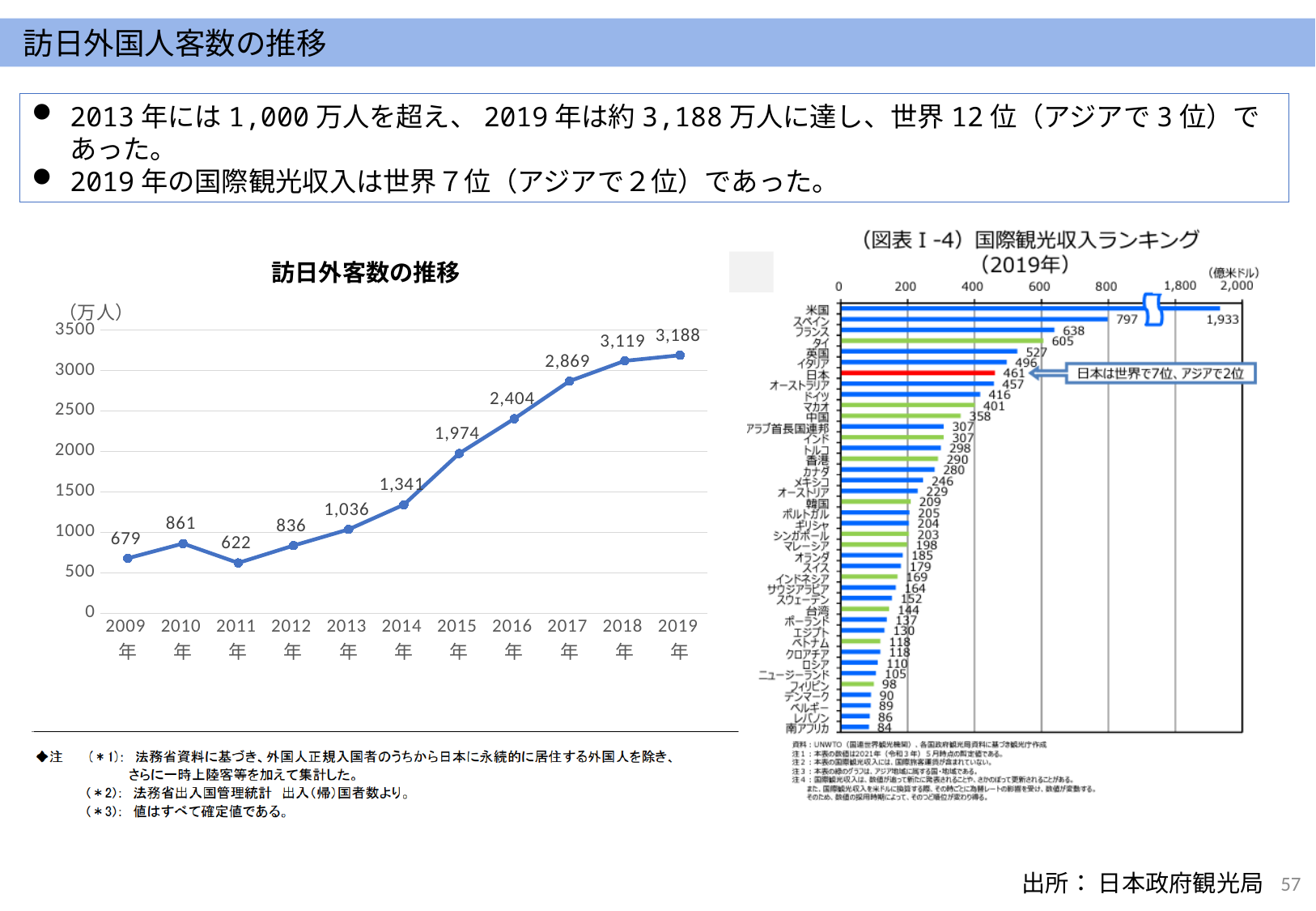
In the line chart titled 訪日外客数の推移, which year has the lowest value? 2011年 In the line chart titled 訪日外客数の推移, do the values generally rise or fall from 2012年 to 2019年? rise What kind of chart is the chart titled 国際観光収入ランキング (2019年) on the right? bar chart In the line chart titled 訪日外客数の推移, how many years are plotted? 11 In the bar chart titled 国際観光収入ランキング (2019年) on the right, which country has the highest value? 米国 In the line chart titled 訪日外客数の推移, what is the difference between the values for 2019年 and 2018年? 69 What kind of chart is the chart titled 訪日外客数の推移 on the left? line chart In the line chart titled 訪日外客数の推移, what is the value for 2019年? 3,188 In the line chart titled 訪日外客数の推移, which year has the highest value? 2019年 In the bar chart titled 国際観光収入ランキング (2019年) on the right, which is larger, the value for スペイン or the value for フランス? スペイン In the bar chart titled 国際観光収入ランキング (2019年) on the right, what is the value for 日本? 461 In the line chart titled 訪日外客数の推移, what is the value for 2013年? 1,036